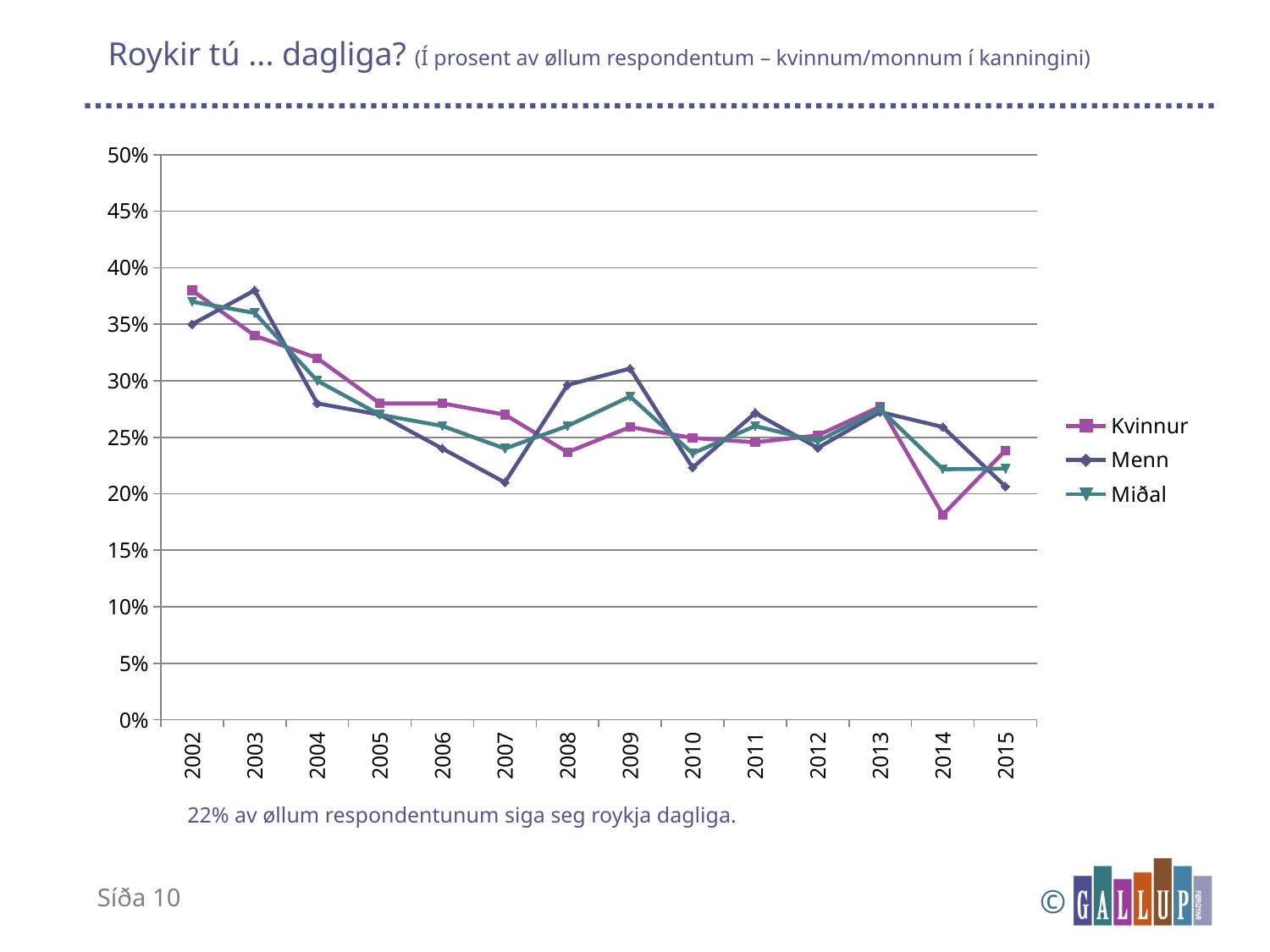
In 2014, which is larger: the value for Menn or the value for Kvinnur? Menn How many series does the legend list? 3 In which year is the value for Kvinnur lowest? 2014 In which year is the value for Menn highest? 2003 How many years are shown on the x axis? 14 What kind of chart is shown on the slide? line chart Overall, do the values for Miðal rise or fall from 2002 to 2015? fall Which series are listed in the legend? Kvinnur, Menn, Miðal Is the value for Menn in 2007 greater or less than 25%? less Is the value for Kvinnur in 2014 greater or less than 20%? less Is the value for Miðal in 2004 greater or less than 25%? greater